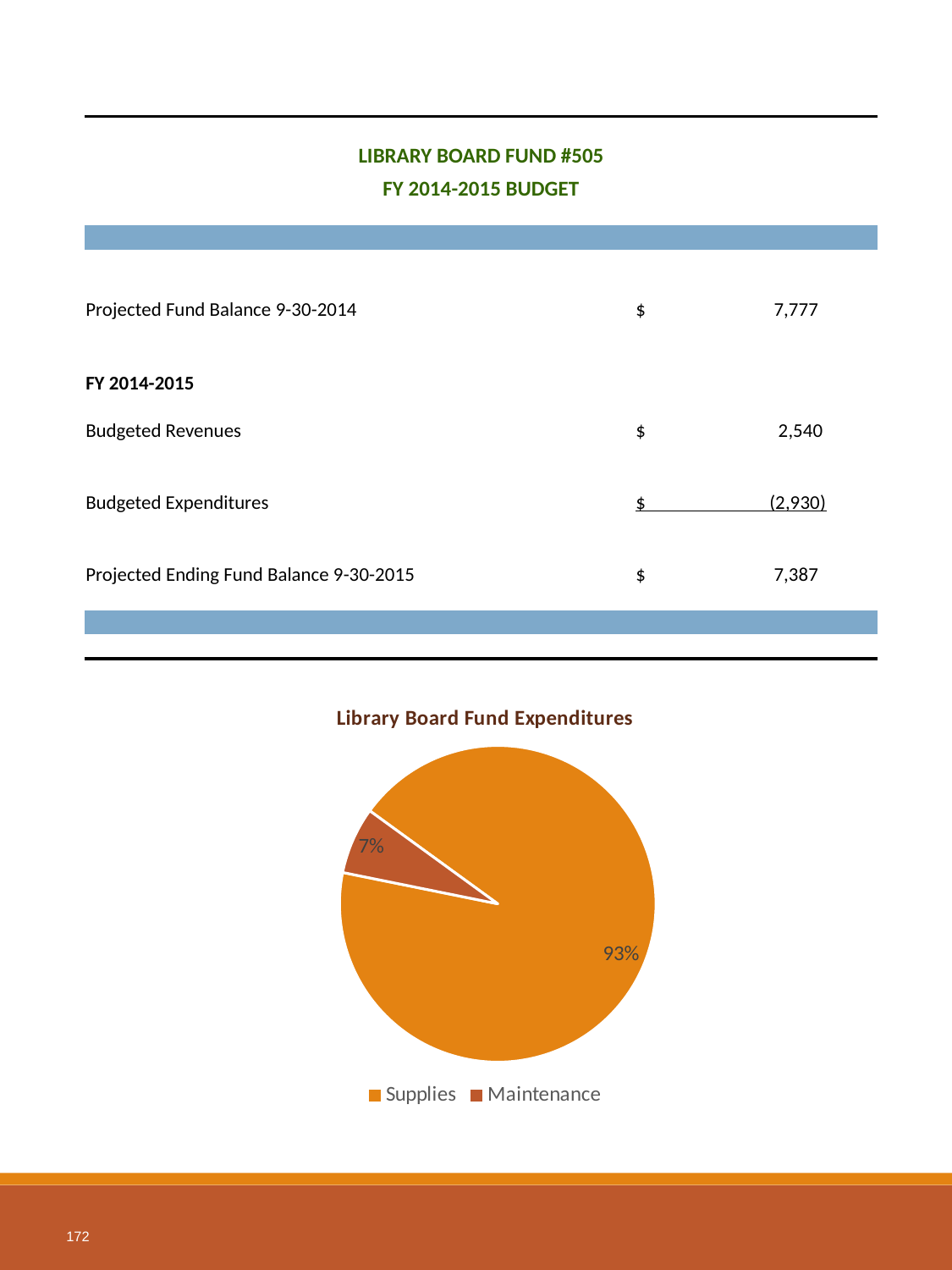
Which category has the smallest slice of the pie? Maintenance Which is larger, the Supplies slice or the Maintenance slice? Supplies What colour is the Maintenance slice in the legend? dark orange-brown What share of the pie does Supplies represent? 93% What kind of chart is shown on the slide? pie chart What share of the pie does Maintenance represent? 7% Which category has the largest slice of the pie? Supplies What is the title of the chart? Library Board Fund Expenditures How many categories does the pie chart show? 2 How many entries does the legend list? 2 What is the difference in percentage points between the Supplies and Maintenance slices? 86